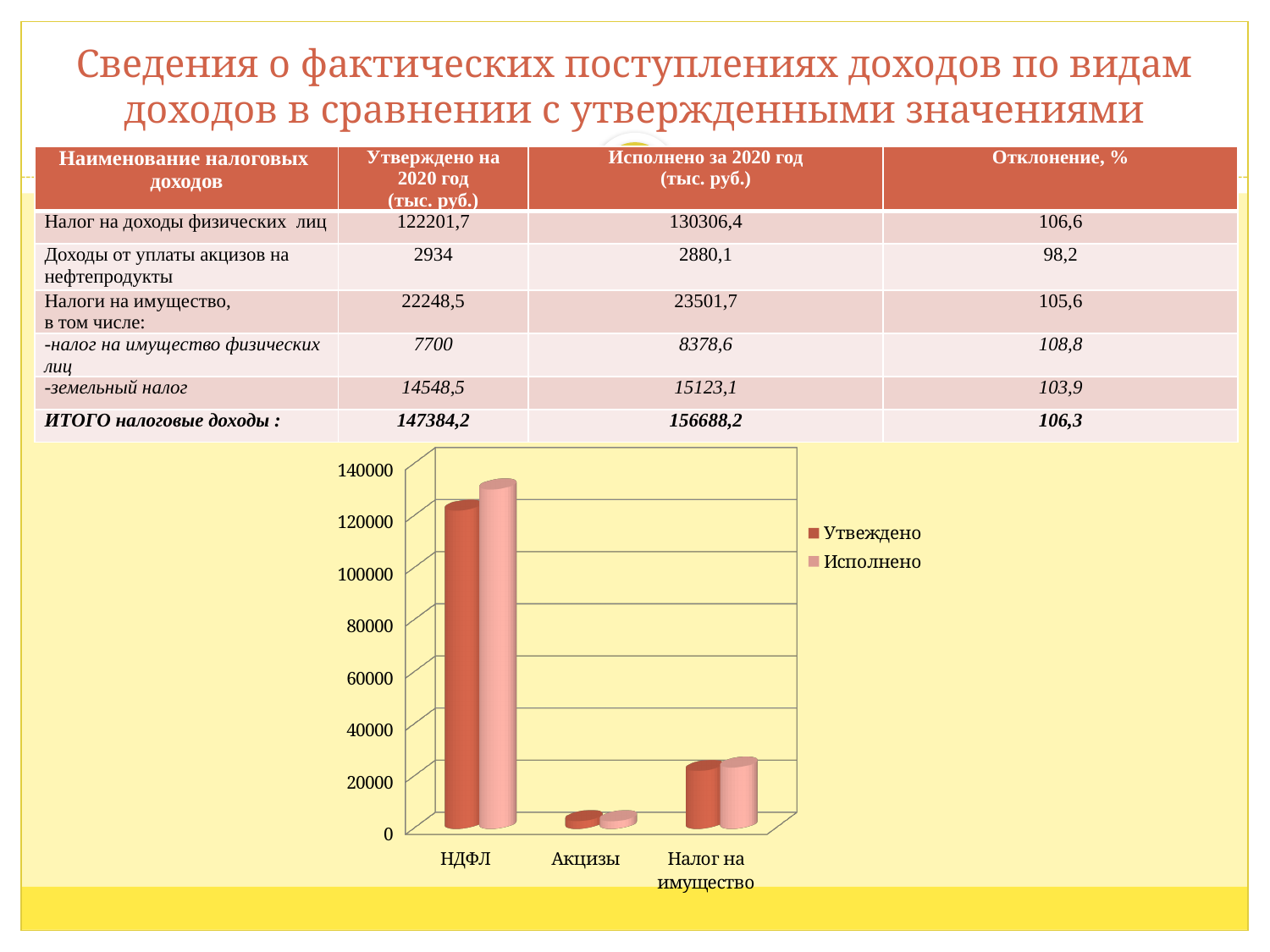
How many series does the chart legend list? 2 Is the Исполнено value for НДФЛ greater or less than 120000? greater What are the two series names listed in the chart legend? Утвеждено, Исполнено How many categories are shown on the x axis of the chart? 3 Is the Утвеждено value for Акцизы greater or less than 20000? less For НДФЛ, which is larger: Утвеждено or Исполнено? Исполнено What kind of chart is shown on the slide? bar chart What is the highest value shown on the chart's vertical axis? 140000 Which category has the lowest bars in the chart? Акцизы Is the Исполнено value for Налог на имущество greater or less than 40000? less Which category has the highest bars in the chart? НДФЛ